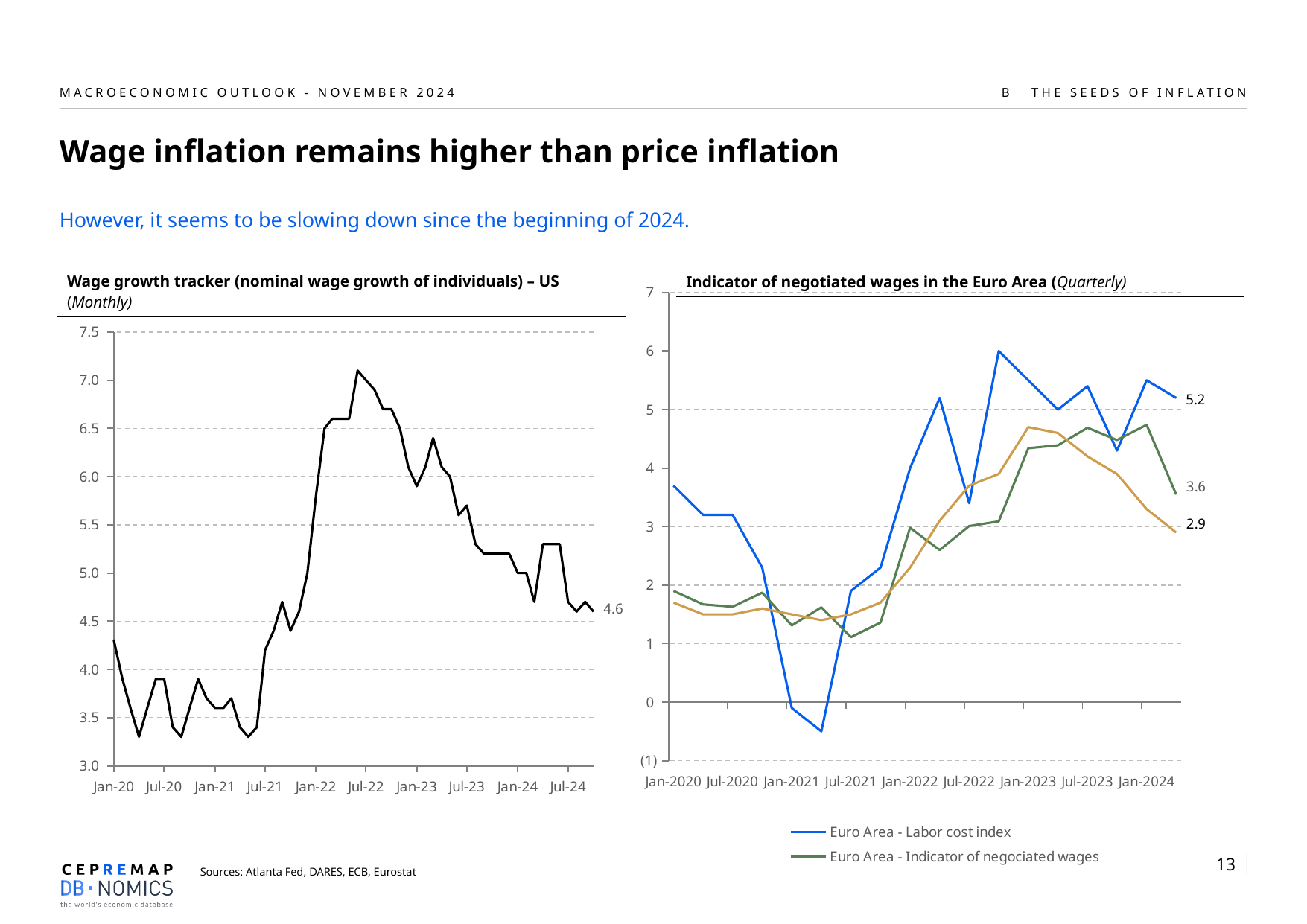
In the left chart (US wage growth tracker), does the series rise or fall between Jul-22 and Jul-24? fall In the right chart (Indicator of negotiated wages in the Euro Area), what is the final labeled value of the Euro Area - Labor cost index? 5.2 In the left chart (US wage growth tracker), what is the value labeled at the end of the series? 4.6 What is the title of the right chart? Indicator of negotiated wages in the Euro Area (Quarterly) In the left chart (US wage growth tracker), is the value at Jan-20 greater or less than 4.0? greater In the right chart (Indicator of negotiated wages in the Euro Area), what is the final labeled value of the Euro Area - Indicator of negociated wages? 3.6 In the right chart (Indicator of negotiated wages in the Euro Area), which series has the higher final labeled value: the Labor cost index or the Indicator of negociated wages? Euro Area - Labor cost index What kind of chart is the left chart, 'Wage growth tracker (nominal wage growth of individuals) – US'? line chart In the right chart (Indicator of negotiated wages in the Euro Area), how many series does the legend list? 2 In the right chart (Indicator of negotiated wages in the Euro Area), is the Labor cost index at Jan-2023 greater or less than 5? greater In the left chart (US wage growth tracker), is the value at Jan-22 greater or less than 6.0? less In the right chart (Indicator of negotiated wages in the Euro Area), what is the difference between the final labeled values of the Labor cost index (5.2) and the Indicator of negociated wages (3.6)? 1.6